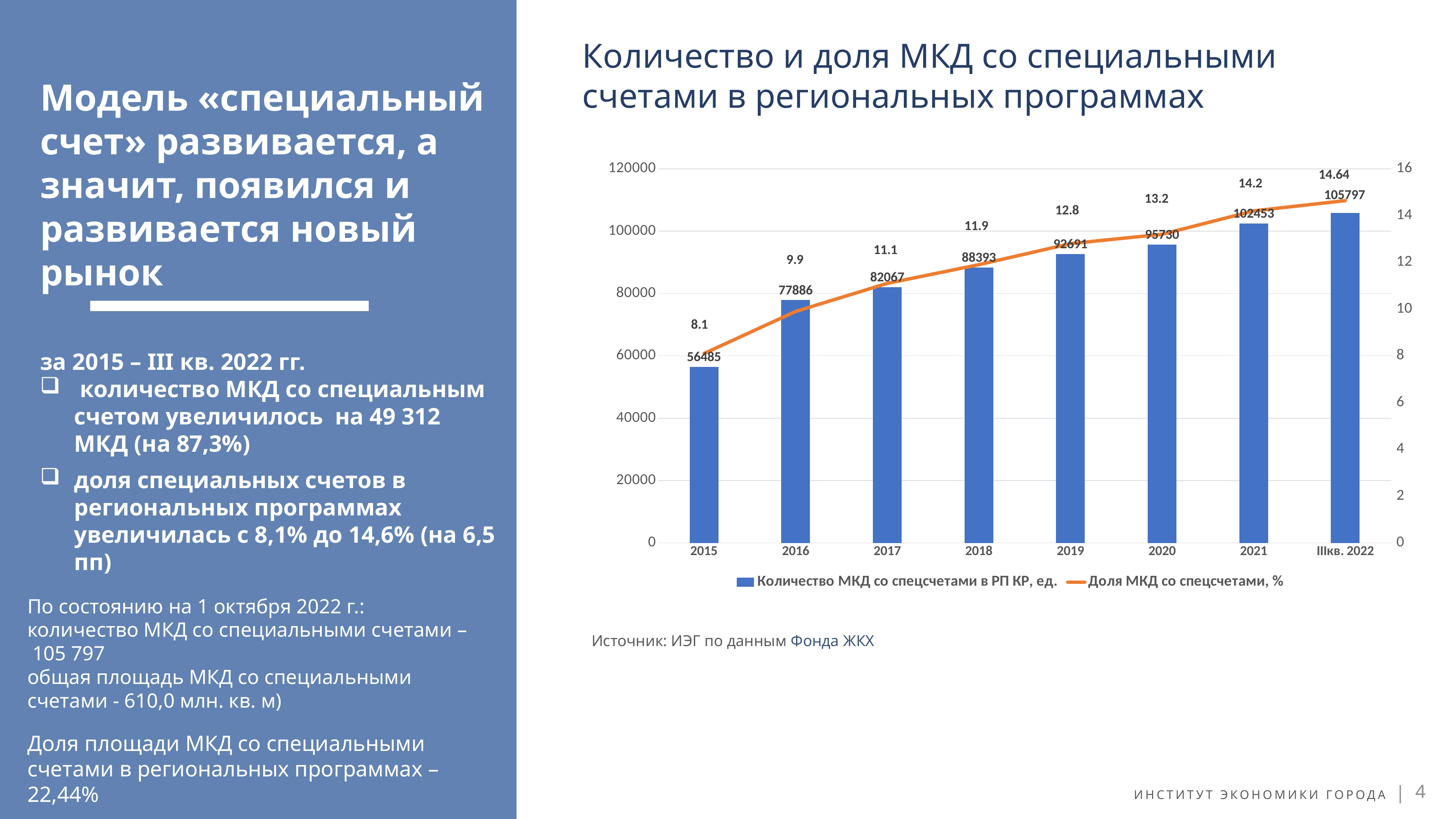
What colour is the line showing the share of MKD with special accounts? orange How many series does the chart legend list? 2 What is the number of MKD with special accounts in IIIкв. 2022? 105797 What is the difference in the number of MKD with special accounts between 2021 and 2020? 6723 What is the share of MKD with special accounts (Доля МКД со спецсчетами, %) in 2019? 12.8 Which period has the highest share of MKD with special accounts? IIIкв. 2022 Which is larger: the number of MKD with special accounts in 2017 or in 2018? 2018 How many periods are shown on the x axis of the chart? 8 Does the share of MKD with special accounts rise or fall from 2015 to IIIкв. 2022? rise What is the number of MKD with special accounts (Количество МКД со спецсчетами в РП КР, ед.) in 2015? 56485 Which period has the lowest number of MKD with special accounts? 2015 Is the number of MKD with special accounts in 2016 greater or less than 80000? less